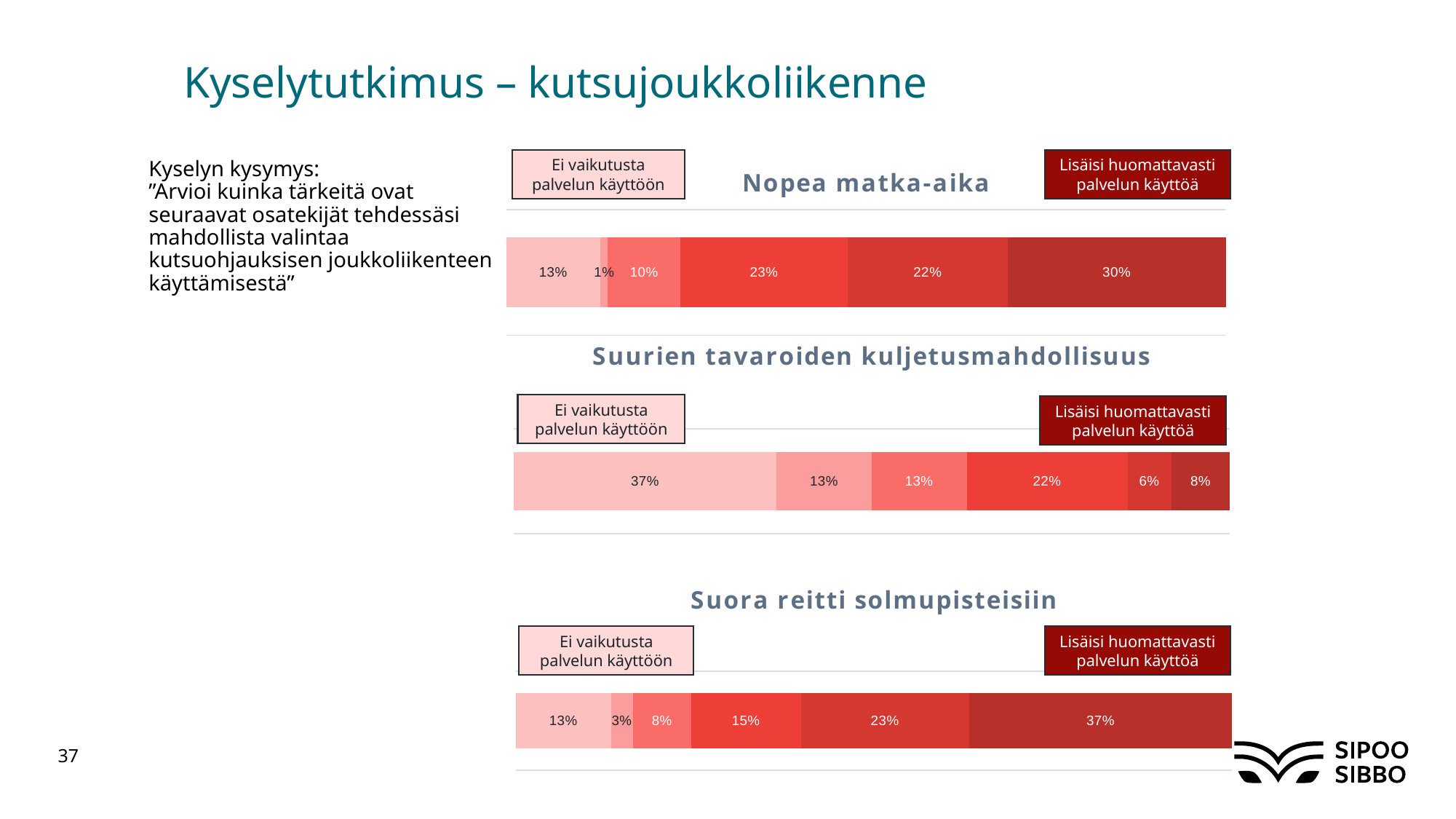
In the 'Nopea matka-aika' chart, what percentage is shown for the lightest segment at the left end of the bar ('Ei vaikutusta palvelun käyttöön')? 13% How many charts are shown on the slide? 3 What type of chart is used for 'Nopea matka-aika'? Stacked bar chart In the 'Nopea matka-aika' chart, what percentage is shown for the darkest segment at the right end of the bar ('Lisäisi huomattavasti palvelun käyttöä')? 30% Which is larger: the rightmost segment in the 'Nopea matka-aika' chart or the rightmost segment in the 'Suora reitti solmupisteisiin' chart? Suora reitti solmupisteisiin (37%) How many segments does the bar in the 'Suora reitti solmupisteisiin' chart have? 6 In the 'Suora reitti solmupisteisiin' chart, which segment has the smallest percentage? The second segment from the left (3%) In the 'Suurien tavaroiden kuljetusmahdollisuus' chart, what percentage is shown for the leftmost segment ('Ei vaikutusta palvelun käyttöön')? 37% In the 'Suurien tavaroiden kuljetusmahdollisuus' chart, what percentage is shown for the rightmost segment ('Lisäisi huomattavasti palvelun käyttöä')? 8% In the 'Nopea matka-aika' chart, which segment has the largest percentage? The rightmost segment (30%) In the 'Suora reitti solmupisteisiin' chart, what percentage is shown for the rightmost segment ('Lisäisi huomattavasti palvelun käyttöä')? 37% In the 'Suurien tavaroiden kuljetusmahdollisuus' chart, what is the difference between the leftmost segment (37%) and the rightmost segment (8%)? 29 percentage points